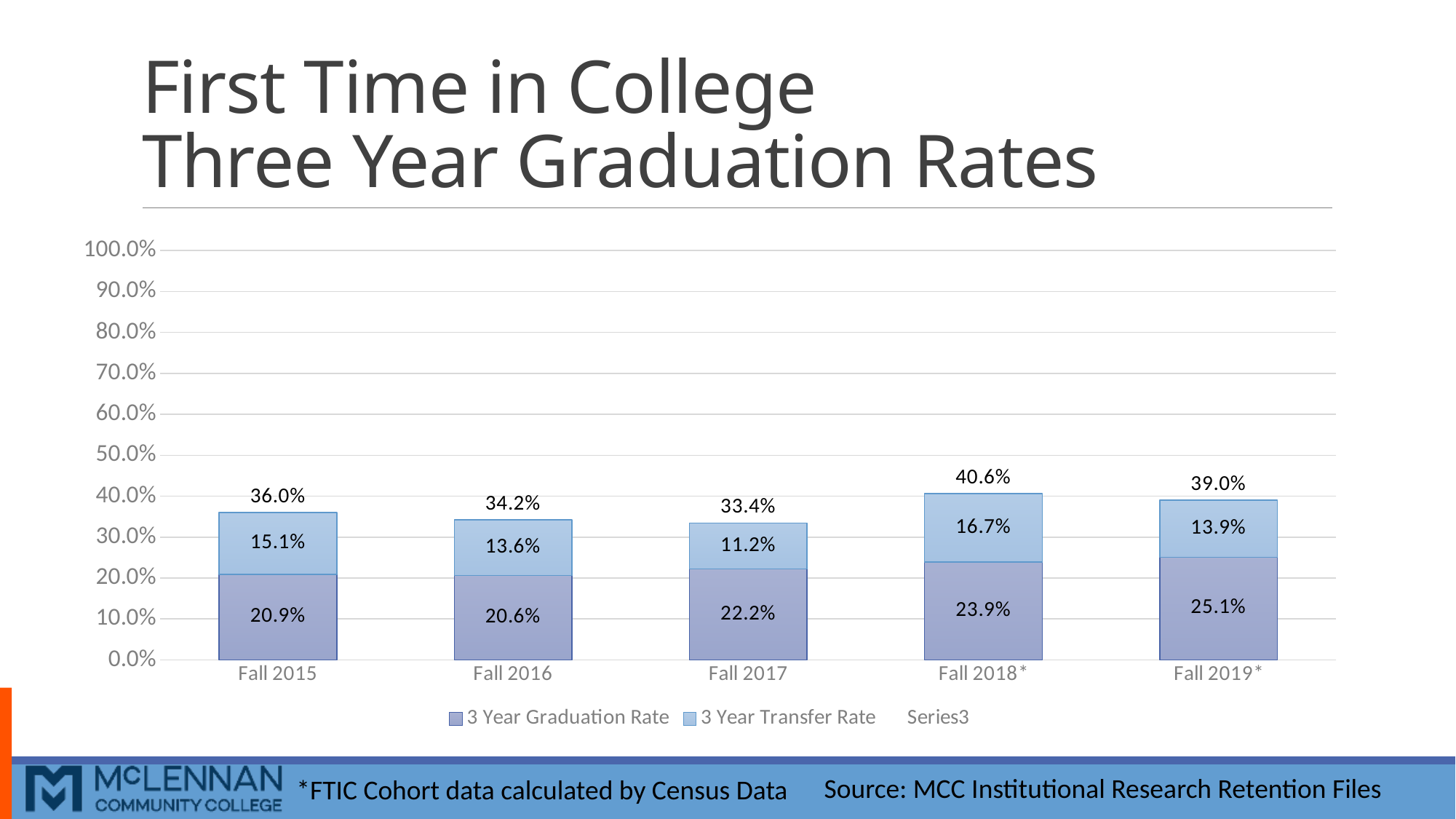
How many cohorts are shown on the x axis? 5 Which cohort has the lowest 3 Year Transfer Rate? Fall 2017 How many entries does the legend list? 3 What is the 3 Year Graduation Rate for Fall 2017? 22.2% Does the 3 Year Graduation Rate rise or fall from Fall 2016 to Fall 2019*? Rise What kind of chart is shown on the slide? Stacked bar chart What is the 3 Year Transfer Rate for Fall 2018*? 16.7% Which cohort has the highest combined total? Fall 2018* Which cohort has the highest 3 Year Graduation Rate? Fall 2019* Is the 3 Year Transfer Rate larger for Fall 2015 or Fall 2016? Fall 2015 What is the total labeled above the Fall 2019* bar? 39.0% What is the difference between the 3 Year Graduation Rate for Fall 2019* and Fall 2015? 4.2%